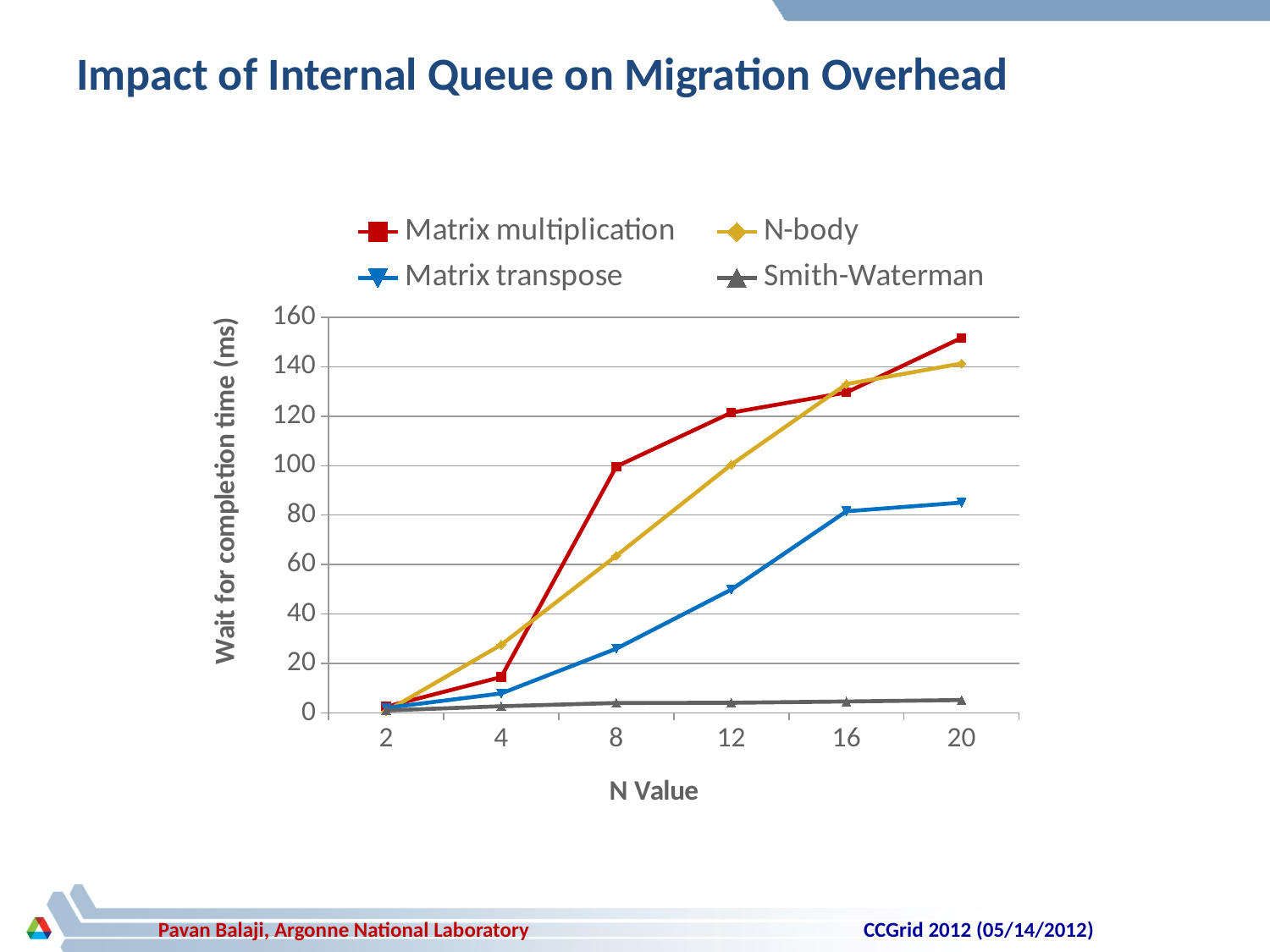
At N = 4, which series has the higher wait for completion time, N-body or Matrix multiplication? N-body Which series has the lowest wait for completion time across all N values? Smith-Waterman What kind of chart is shown on the slide? line chart Does the wait for completion time for N-body rise or fall as N increases? rise Which series has the highest wait for completion time at N = 20? Matrix multiplication How many series does the legend list? 4 What is the label of the y axis? Wait for completion time (ms) Is the value for Matrix multiplication at N = 20 greater or less than 140? greater How many N values are plotted along the x axis? 6 At N = 8, which series has the higher wait for completion time, Matrix multiplication or N-body? Matrix multiplication Is the value for Matrix transpose at N = 16 greater or less than 60? greater Is the value for Smith-Waterman at N = 20 greater or less than 20? less